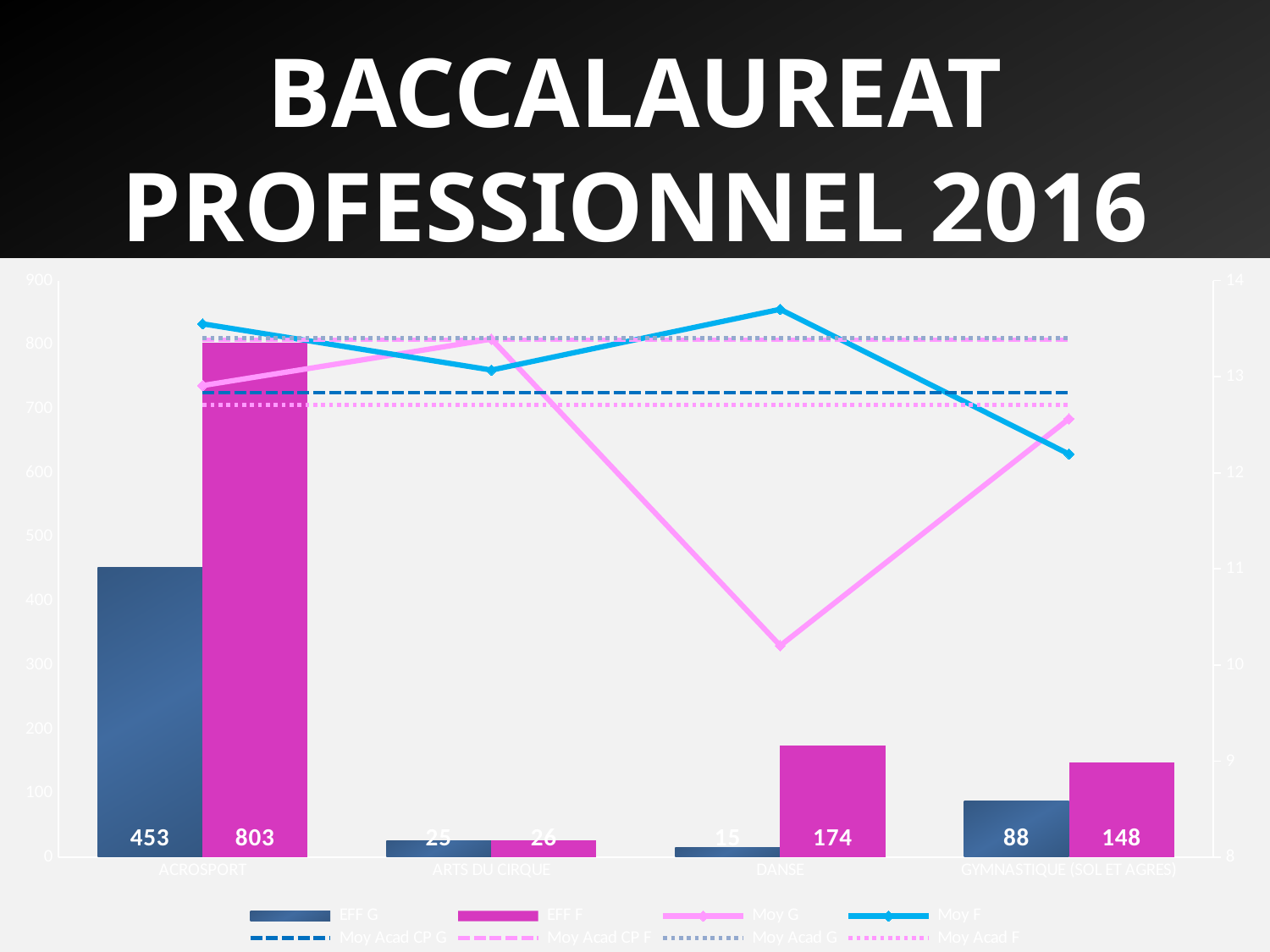
Which category has the lowest EFF G value? DANSE Is the Moy G value for DANSE greater or less than 11? less Which category has the highest EFF G value? ACROSPORT How many series does the legend list? 8 What is the EFF G value for GYMNASTIQUE (SOL ET AGRES)? 88 What is the difference between the EFF F and EFF G values for ACROSPORT? 350 What is the title of the slide? BACCALAUREAT PROFESSIONNEL 2016 Is the Moy F value for DANSE greater or less than 13? greater What is the EFF F value for ACROSPORT? 803 Which is larger for GYMNASTIQUE (SOL ET AGRES): EFF G or EFF F? EFF F What is the EFF F value for DANSE? 174 How many categories are shown on the x axis? 4